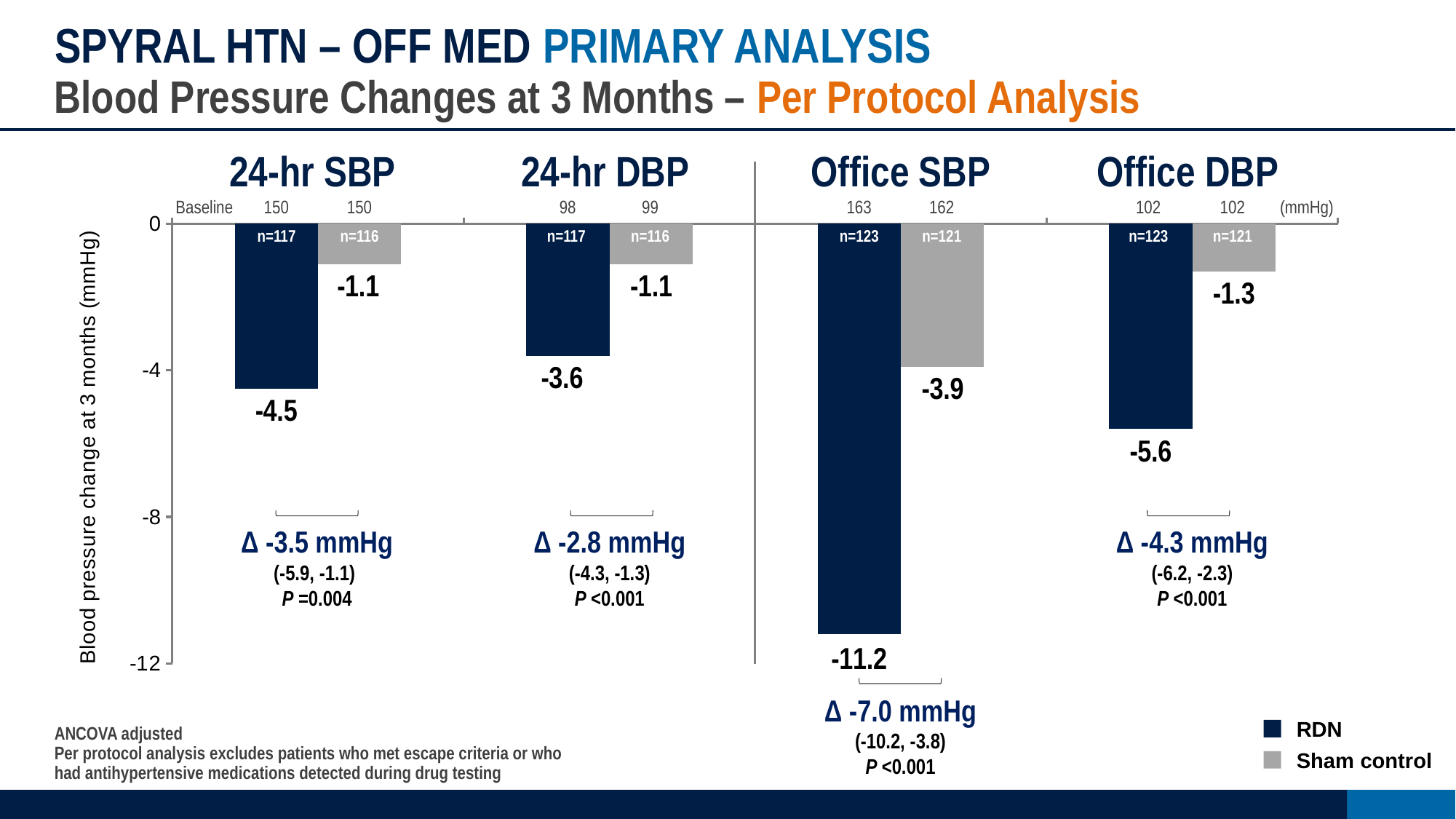
What is the blood pressure change at 3 months for Sham control in the Office SBP group? -3.9 Is the RDN value for Office SBP below -8 on the axis? Yes What is the blood pressure change at 3 months for RDN in the Office DBP group? -5.6 What kind of chart is shown on the slide? Bar chart How many series does the legend list? 2 Which group shows the smallest blood pressure reduction for Sham control? 24-hr SBP and 24-hr DBP (both -1.1) What is the blood pressure change at 3 months for RDN in the 24-hr SBP group? -4.5 What is the difference between the RDN and Sham control changes in the Office SBP group, based on the bar labels? 7.3 Which group shows the largest blood pressure reduction for RDN? Office SBP Which has a larger blood pressure reduction: RDN in 24-hr SBP or RDN in 24-hr DBP? RDN in 24-hr SBP What is the blood pressure change at 3 months for Sham control in the 24-hr DBP group? -1.1 How many blood pressure measurement groups are shown on the chart? 4